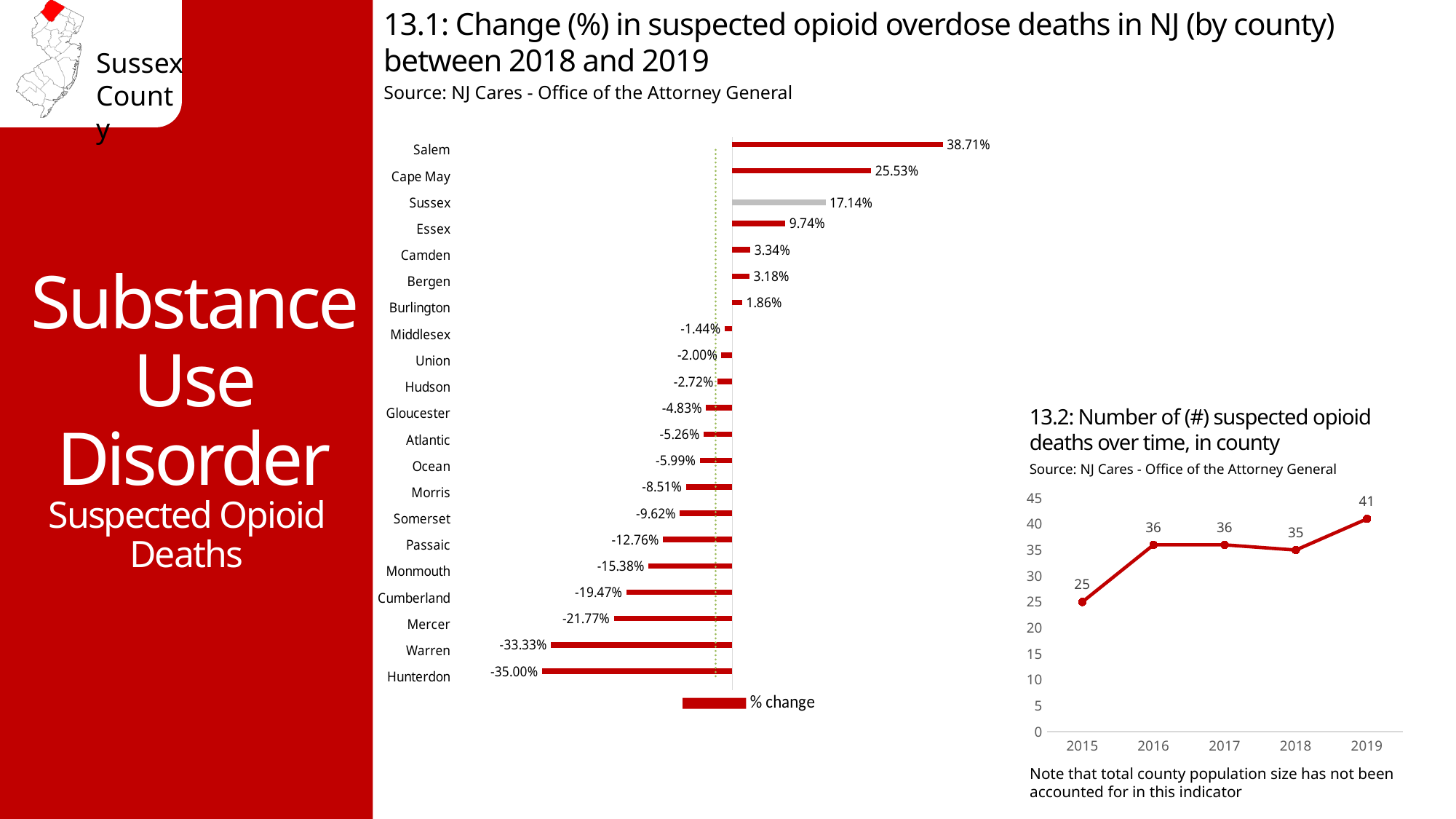
What kind of chart is chart 13.1? Bar chart In chart 13.1, what is the % change for Warren? -33.33% In chart 13.2, what is the number of suspected opioid deaths in 2019? 41 In chart 13.1, how many counties are shown? 21 In chart 13.1, what is the % change for Sussex? 17.14% In chart 13.1, which county has the highest % change? Salem In chart 13.2, which year has the lowest number of suspected opioid deaths? 2015 In chart 13.2, what is the difference in suspected opioid deaths between 2015 and 2019? 16 In chart 13.1, which is larger, the % change for Essex or for Camden? Essex In chart 13.1, what is the % change for Cape May? 25.53% In chart 13.1, which county has the lowest % change? Hunterdon What kind of chart is chart 13.2? Line chart